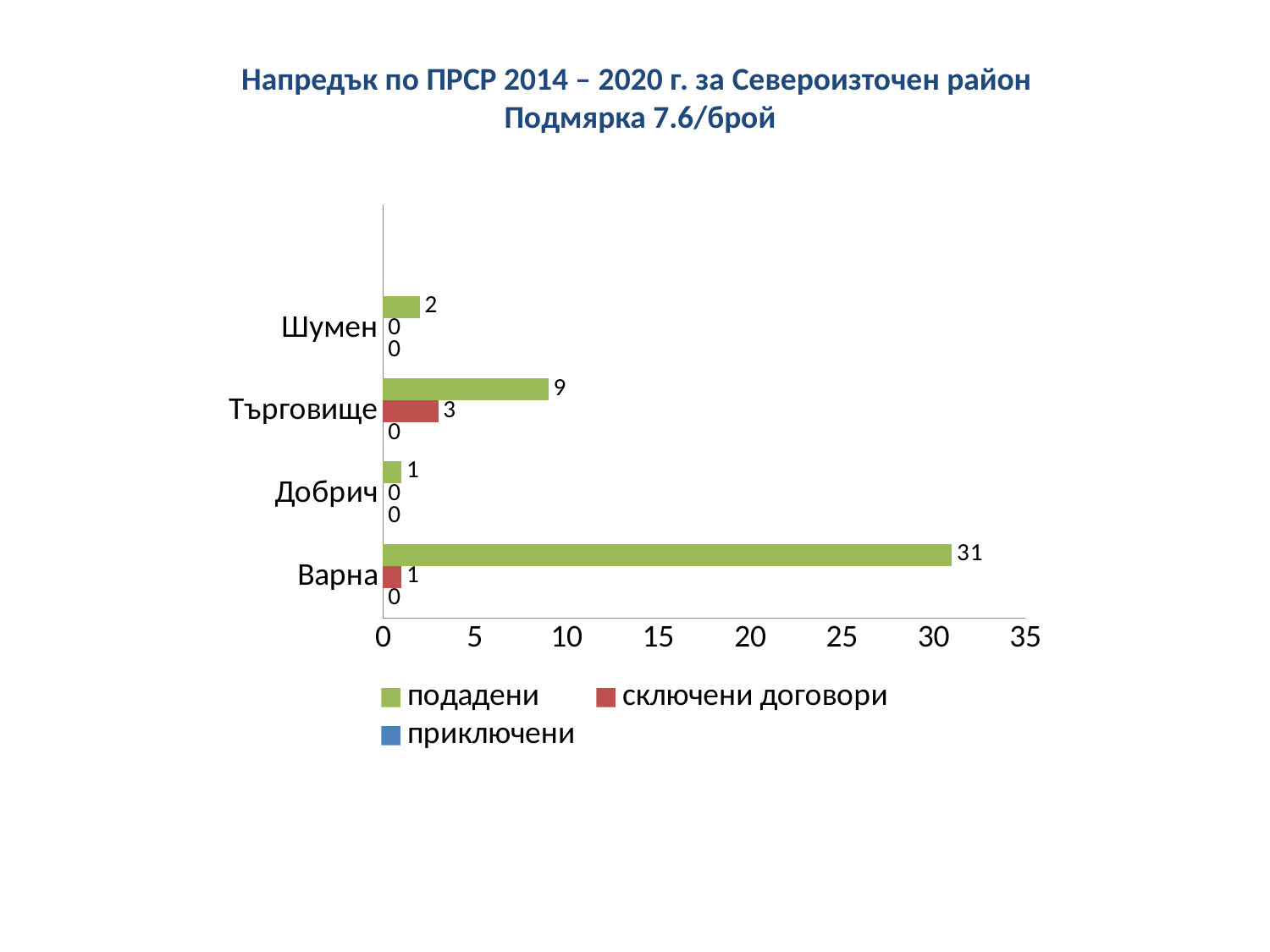
Which category has the highest value of подадени? Варна Which is larger: сключени договори for Търговище or сключени договори for Варна? Търговище What is the value of подадени for Шумен? 2 What is the title of the chart? Напредък по ПРСР 2014 – 2020 г. за Североизточен район Подмярка 7.6/брой What is the value of сключени договори for Търговище? 3 What is the value of подадени for Варна? 31 What kind of chart is shown on the slide? bar chart How many series does the legend list? 3 What is the value of приключени for Добрич? 0 How many categories are shown on the y axis? 4 Which category has the lowest value of подадени? Добрич What is the difference between подадени for Варна and подадени for Търговище? 22